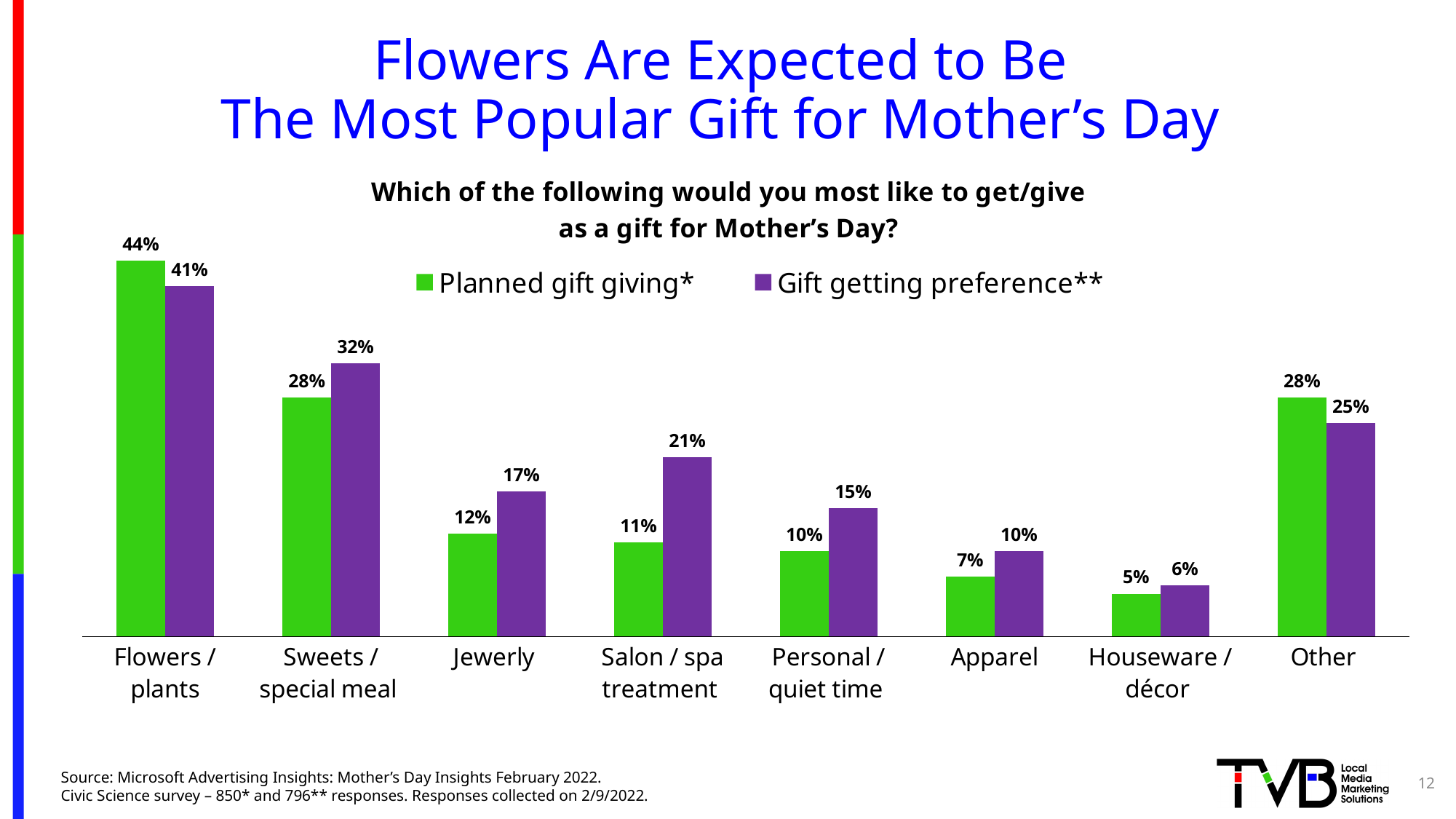
What is the Planned gift giving value for Houseware / décor? 5% Which category has the lowest Planned gift giving value? Houseware / décor What is the difference between the Gift getting preference and Planned gift giving values for Jewerly? 5% What kind of chart is shown on the slide? Bar chart How many categories are shown on the x axis? 8 How many series does the legend list? 2 What is the difference between the Planned gift giving values for Flowers / plants and Other? 16% Which category has the highest Gift getting preference value? Flowers / plants For Sweets / special meal, which is larger: Planned gift giving or Gift getting preference? Gift getting preference What is the Planned gift giving value for Flowers / plants? 44% What is the Gift getting preference value for Salon / spa treatment? 21% Which colour represents the Planned gift giving series? Green